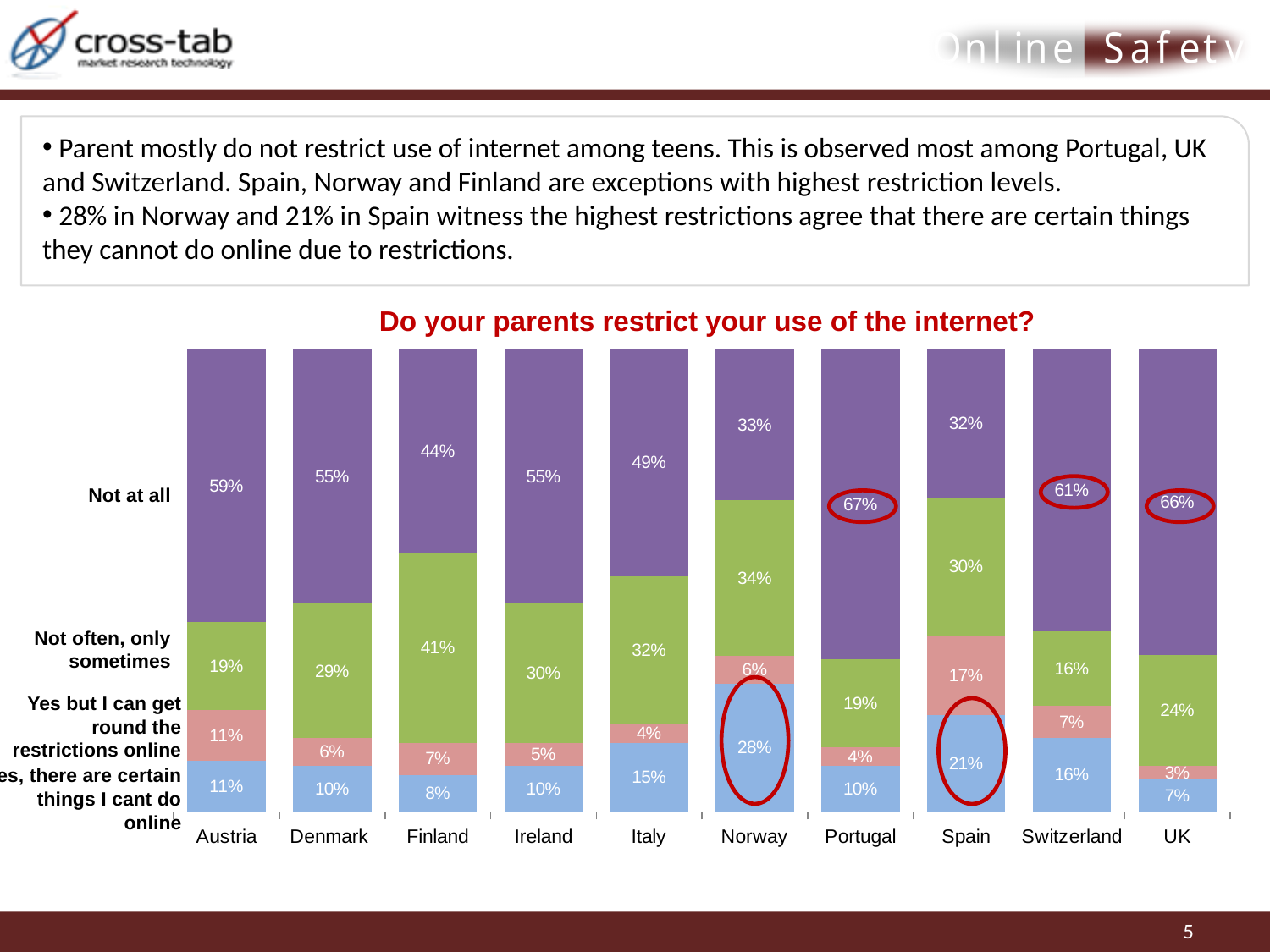
How many countries are shown on the x axis of the chart? 10 Which country has the highest share of teens answering "Not at all"? Portugal Which country has the lowest share of teens answering "Not at all"? Spain What is the title of the chart? Do your parents restrict your use of the internet? What percentage of teens in Norway said "Yes, there are certain things I cant do online"? 28% Which country has a larger "Not often, only sometimes" value, Finland or Denmark? Finland What is the value for "Yes but I can get round the restrictions online" for the UK? 3% How many response categories (series) are stacked in each bar? 4 What type of chart is shown on the slide? Stacked bar chart What is the difference in percentage points between Portugal's and Spain's "Not at all" values? 35 percentage points Which country has the highest value for "Yes but I can get round the restrictions online"? Spain What percentage of teens in Portugal answered "Not at all" to whether their parents restrict their internet use? 67%